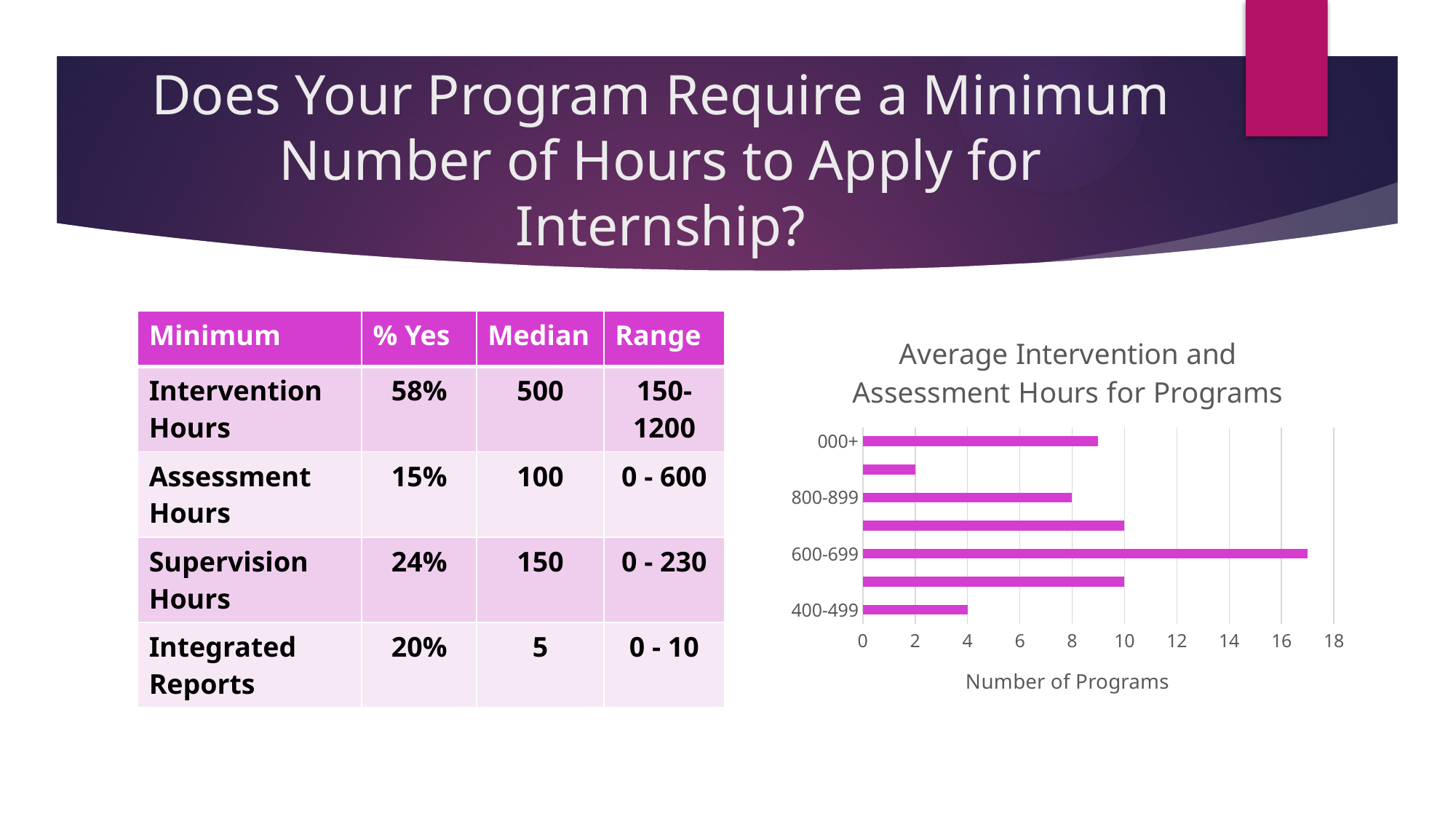
What is the number of programs for the 800-899 category? 8 How many bars are plotted in the chart? 7 Is the value for 600-699 greater or less than 16? greater What type of chart is shown on the slide? bar chart Is the value for 400-499 greater or less than 6? less Which labeled category has the highest number of programs? 600-699 What is the number of programs for the 400-499 category? 4 What is the difference in number of programs between 800-899 and 400-499? 4 Is the value for the top bar (labeled 000+) greater or less than 10? less What is the title of the chart? Average Intervention and Assessment Hours for Programs What is the label of the horizontal axis of the chart? Number of Programs Which has more programs, 800-899 or 400-499? 800-899